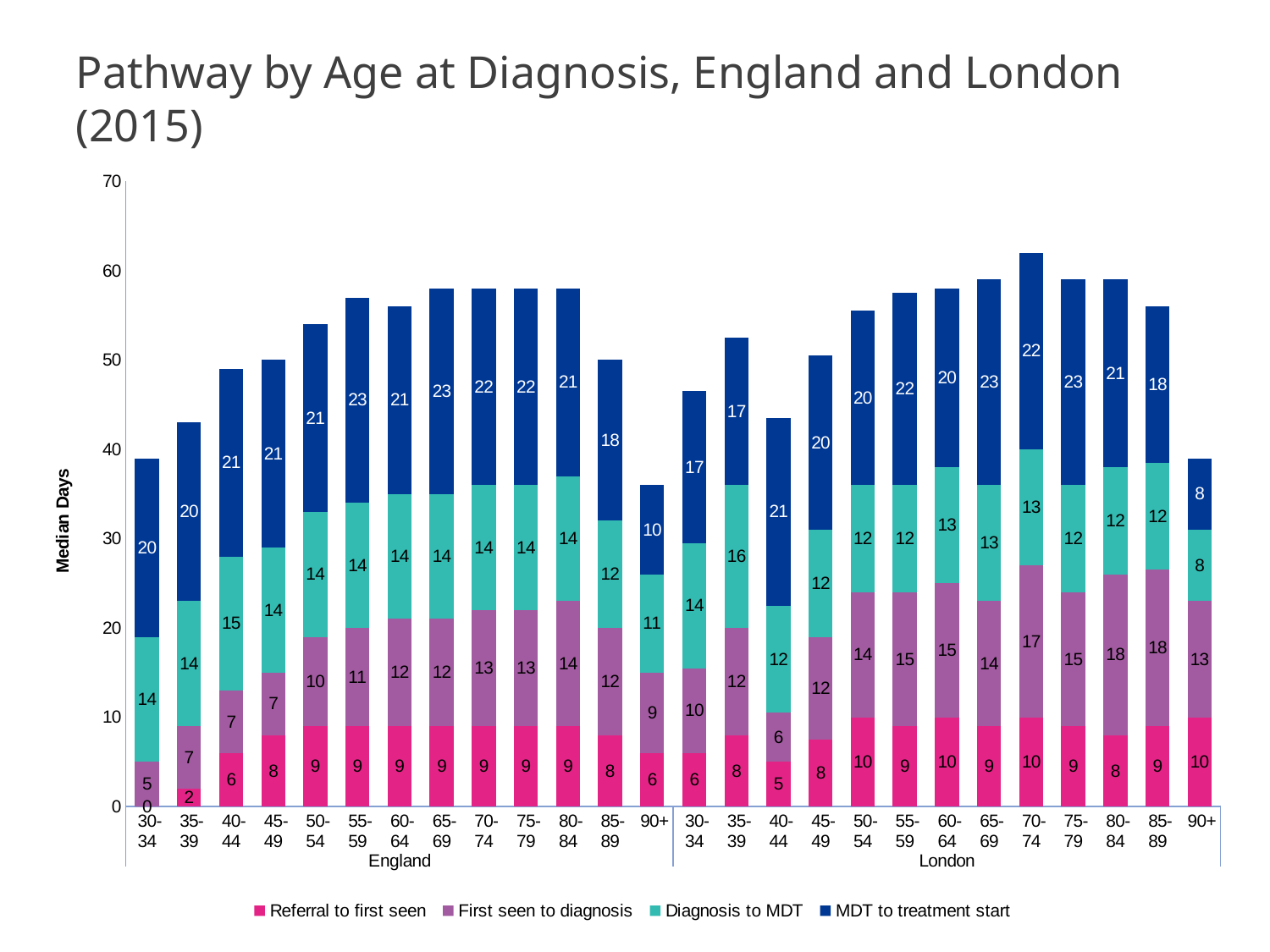
Within England, which age group has the highest First seen to diagnosis value? 80-84 Within England, which age group has the lowest Referral to first seen value? 30-34 What kind of chart is shown on the slide? Stacked bar chart What is the MDT to treatment start value for the England 55-59 age group? 23 How many series does the legend list? 4 For the London 40-44 age group, what is the difference between the MDT to treatment start value and the Diagnosis to MDT value? 9 For the England 90+ age group, which is larger: Diagnosis to MDT or MDT to treatment start? Diagnosis to MDT What is the total median days for the England 90+ stacked bar? 36 How many age groups are shown for London? 13 What is the First seen to diagnosis value for the London 70-74 age group? 17 What is the Referral to first seen value for the England 30-34 age group? 0 Is the total height of the London 70-74 bar greater or less than 60? greater